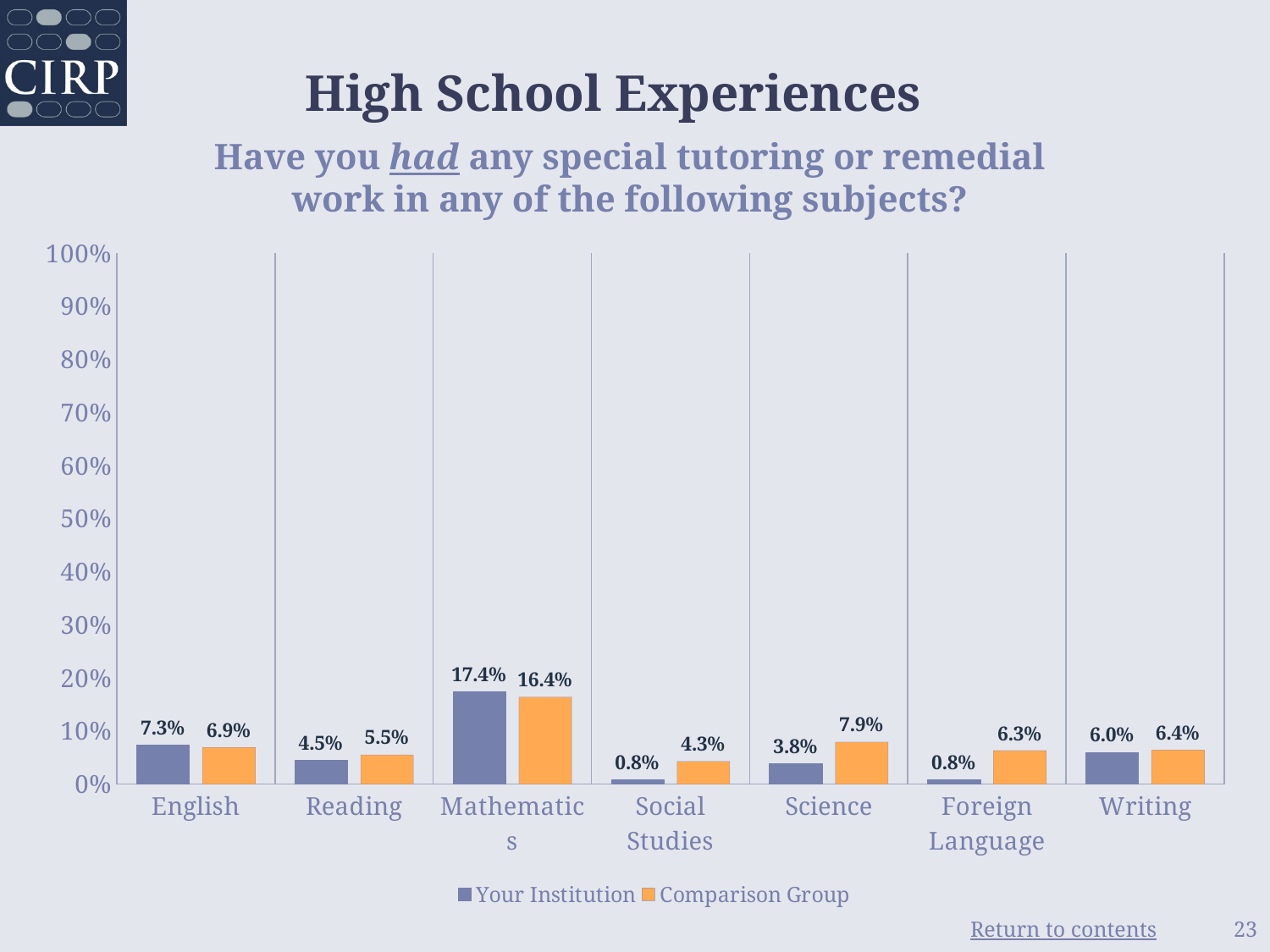
Is the value for Your Institution in Mathematics greater or less than 10%? greater Which subject has the lowest value for Comparison Group? Social Studies What is the value for Your Institution in Foreign Language? 0.8% What kind of chart is shown on the slide? bar chart Which subject has the highest value for Comparison Group? Mathematics How many series does the legend list? 2 What is the difference between Your Institution and Comparison Group in Science? 4.1% What is the difference between Your Institution and Comparison Group in Mathematics? 1.0% What is the value for Comparison Group in Science? 7.9% How many subjects are shown on the x axis? 7 Which is larger in Foreign Language: Your Institution or Comparison Group? Comparison Group What is the value for Your Institution in Mathematics? 17.4%